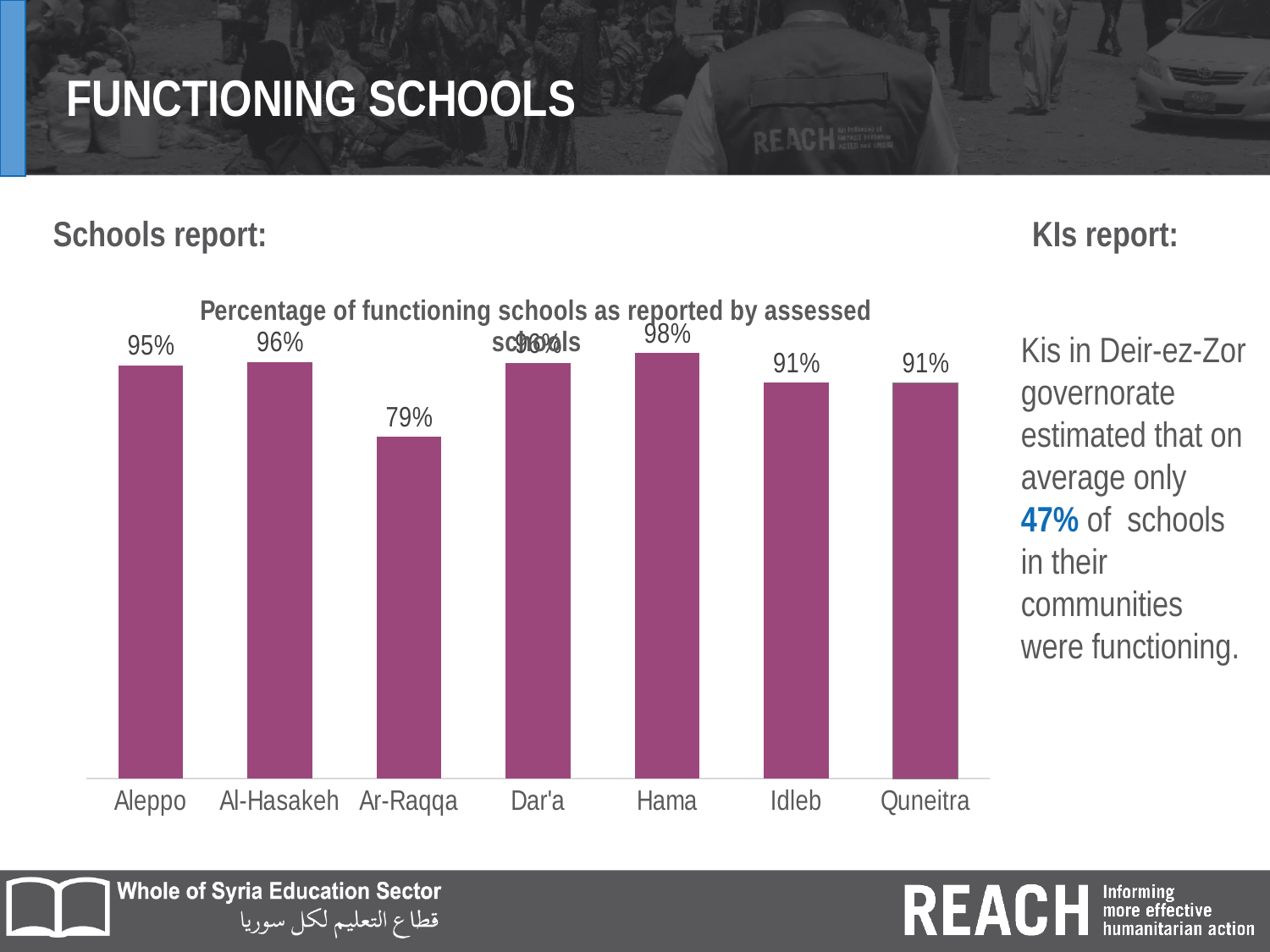
What is the title of the chart? Percentage of functioning schools as reported by assessed schools What is the percentage of functioning schools reported for Aleppo? 95% What is the percentage of functioning schools reported for Idleb? 91% What is the difference in percentage points between Hama and Ar-Raqqa? 19 percentage points Which governorate has the lowest percentage of functioning schools in the chart? Ar-Raqqa What type of chart is shown on the slide? Bar chart Which governorate has the highest percentage of functioning schools in the chart? Hama What is the percentage of functioning schools reported for Quneitra? 91% How many governorates are shown in the chart? 7 Which has a higher percentage of functioning schools, Aleppo or Al-Hasakeh? Al-Hasakeh What is the percentage of functioning schools reported for Ar-Raqqa? 79% What is the percentage of functioning schools reported for Hama? 98%